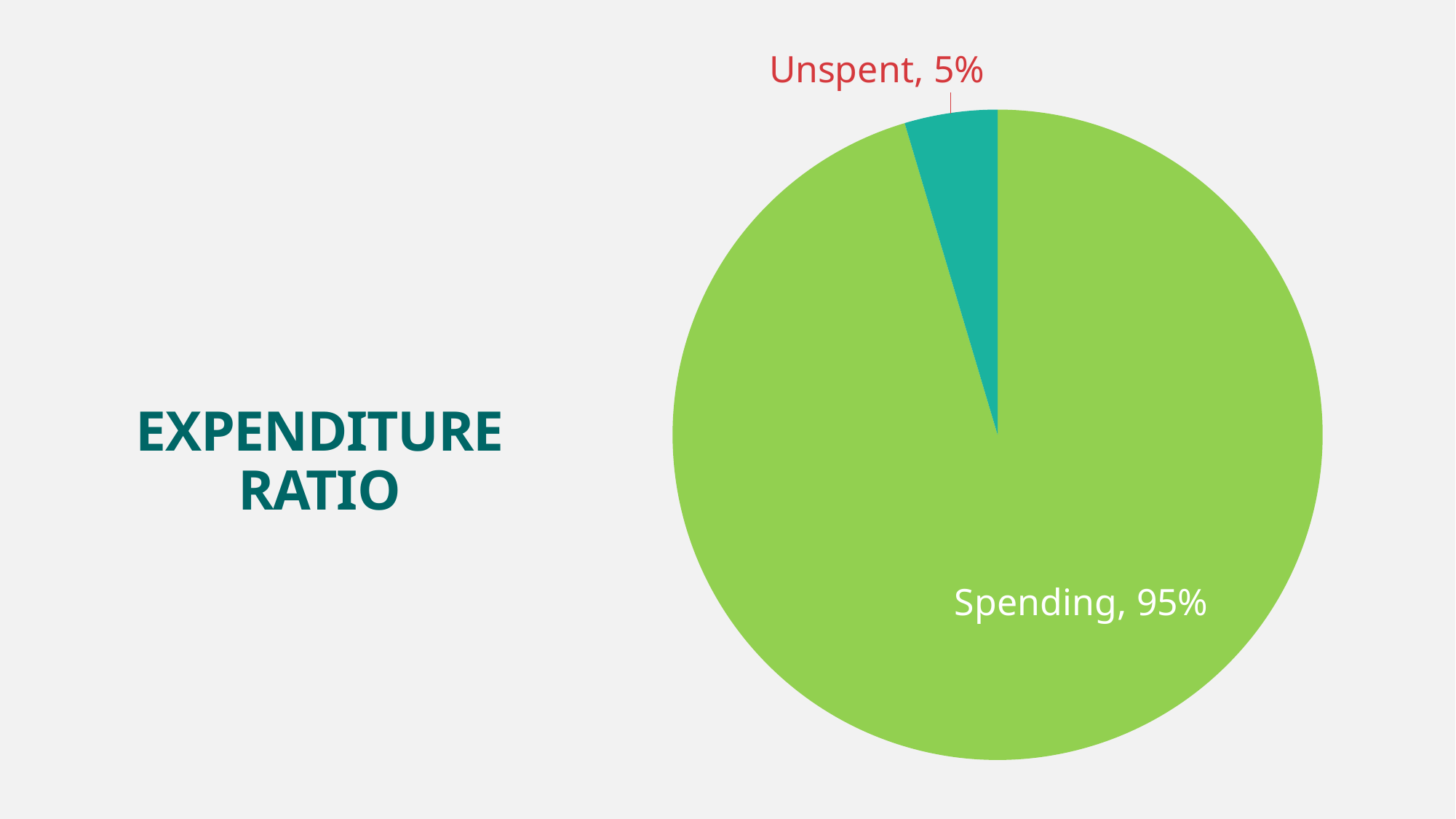
What is the difference in percentage points between the Spending and Unspent slices? 90 What colour is the Unspent slice of the pie? teal What is the title text shown next to the pie chart? EXPENDITURE RATIO How many slices does the pie chart have? 2 Which slice of the pie is the smallest? Unspent What share of the pie does Spending take? 95% What share of the pie does Unspent take? 5% Which is larger, the Spending slice or the Unspent slice? Spending Which slice of the pie is the largest? Spending What kind of chart is shown on the slide? pie chart